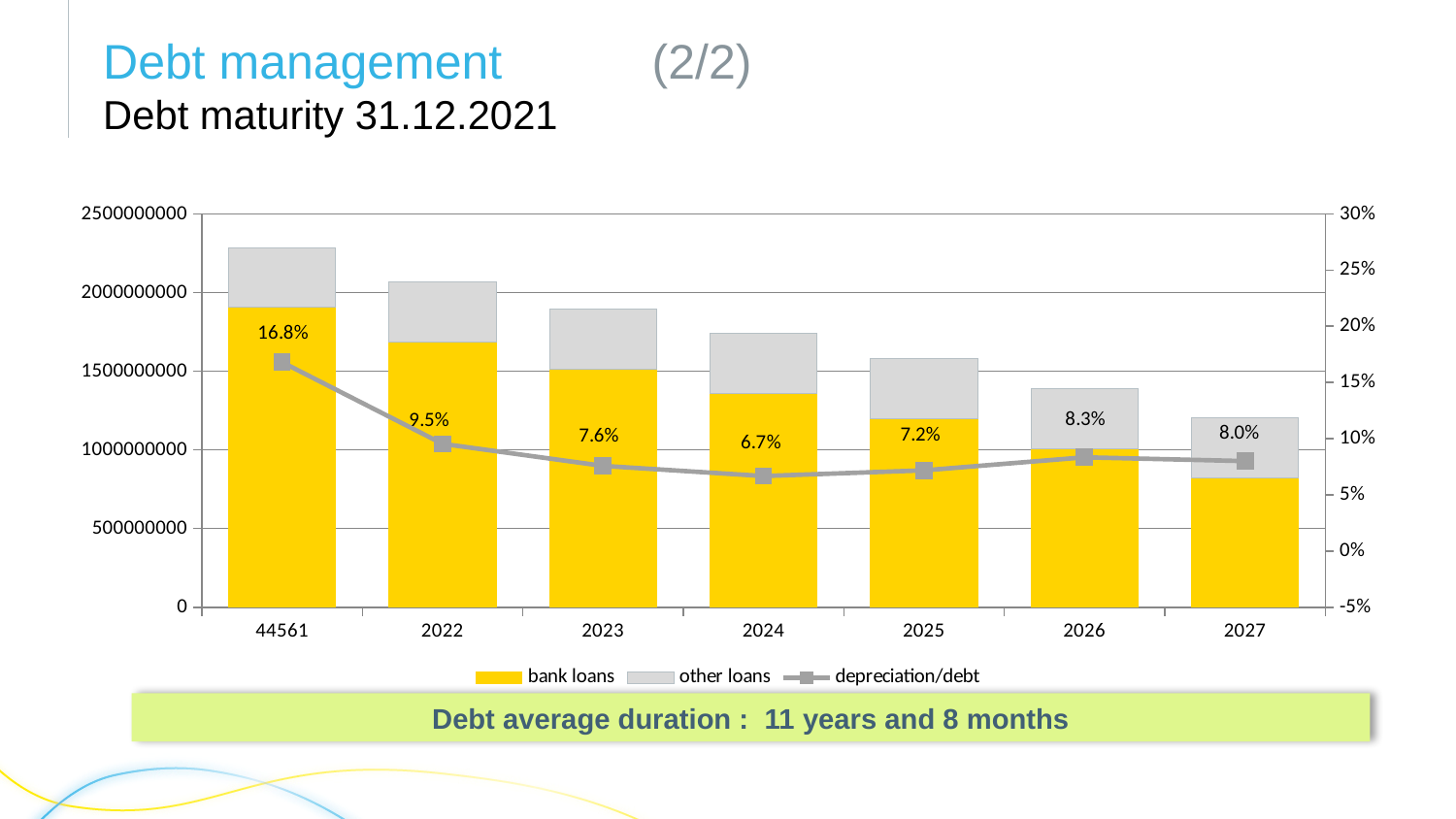
Does the depreciation/debt line rise or fall from 44561 to 2024? fall Is the bank loans value for 2027 greater or less than 1000000000? less What is the depreciation/debt value for the first category, labelled 44561? 16.8% Is the total stacked bar for 44561 greater or less than 2000000000? greater How many series does the legend list? 3 What is the difference between the depreciation/debt values for 44561 and 2022? 7.3 percentage points What kind of chart is this? Combined stacked bar and line chart Which category has the highest depreciation/debt value? 44561 Which category has the lowest depreciation/debt value? 2024 How many categories are shown on the x axis? 7 What is the depreciation/debt value for 2023? 7.6% Which has the larger depreciation/debt value, 2025 or 2026? 2026